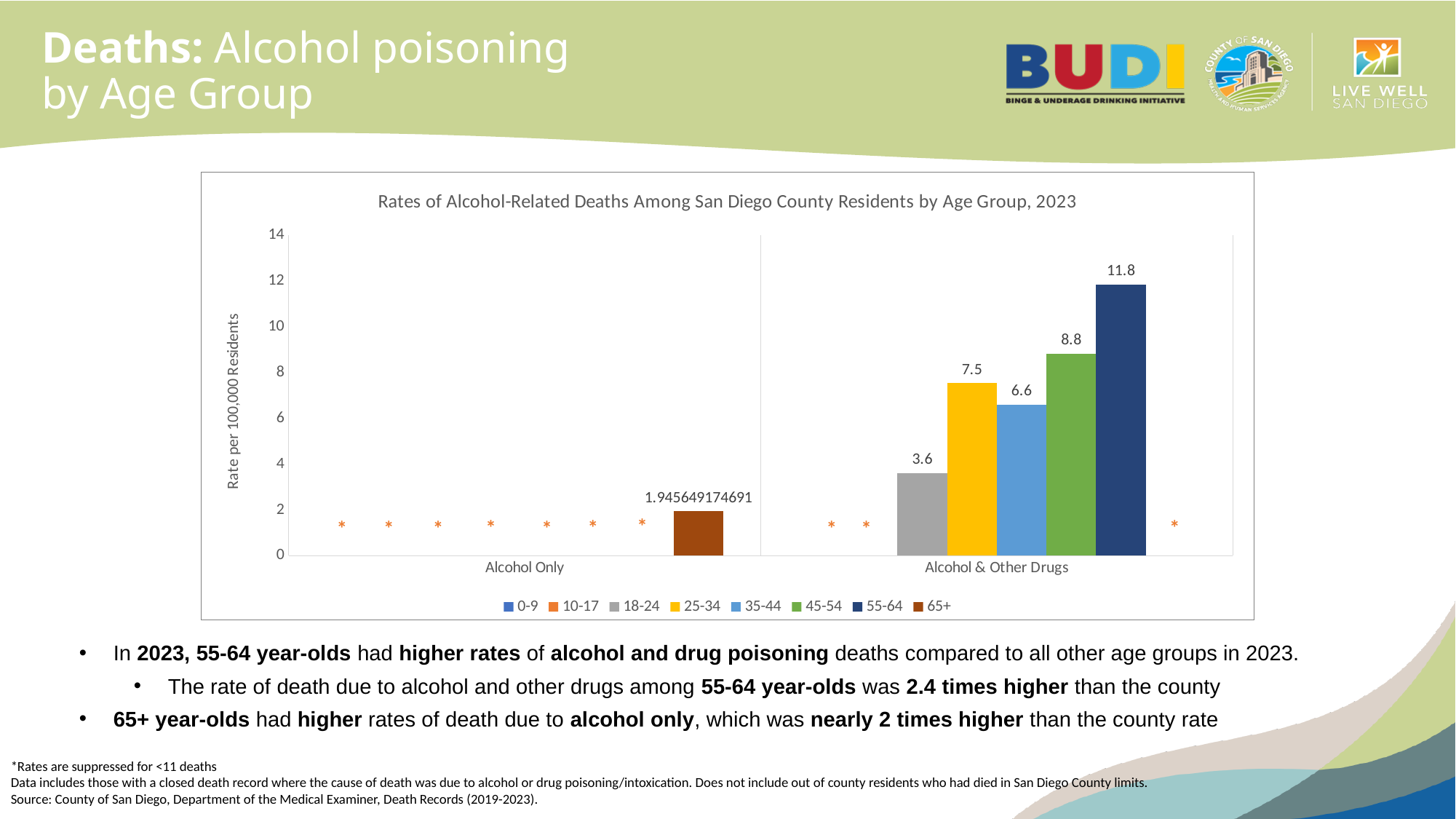
What kind of chart is shown on the slide? Bar chart What is the label on the vertical axis of the chart? Rate per 100,000 Residents Is the value for 55-64 in the Alcohol & Other Drugs category greater or less than 10? greater What is the rate for the 45-54 age group in the Alcohol & Other Drugs category? 8.8 What is the rate for the 55-64 age group in the Alcohol & Other Drugs category? 11.8 Which age group has the lowest labelled rate in the Alcohol & Other Drugs category? 18-24 In the Alcohol & Other Drugs category, which is larger: the rate for 25-34 or the rate for 35-44? 25-34 How many age groups does the legend list? 8 Which age group has the highest rate in the Alcohol & Other Drugs category? 55-64 What value is labelled on the 65+ bar in the Alcohol Only category? 1.945649174691 What is the difference between the 55-64 and 45-54 rates in the Alcohol & Other Drugs category? 3.0 What is the rate for the 18-24 age group in the Alcohol & Other Drugs category? 3.6